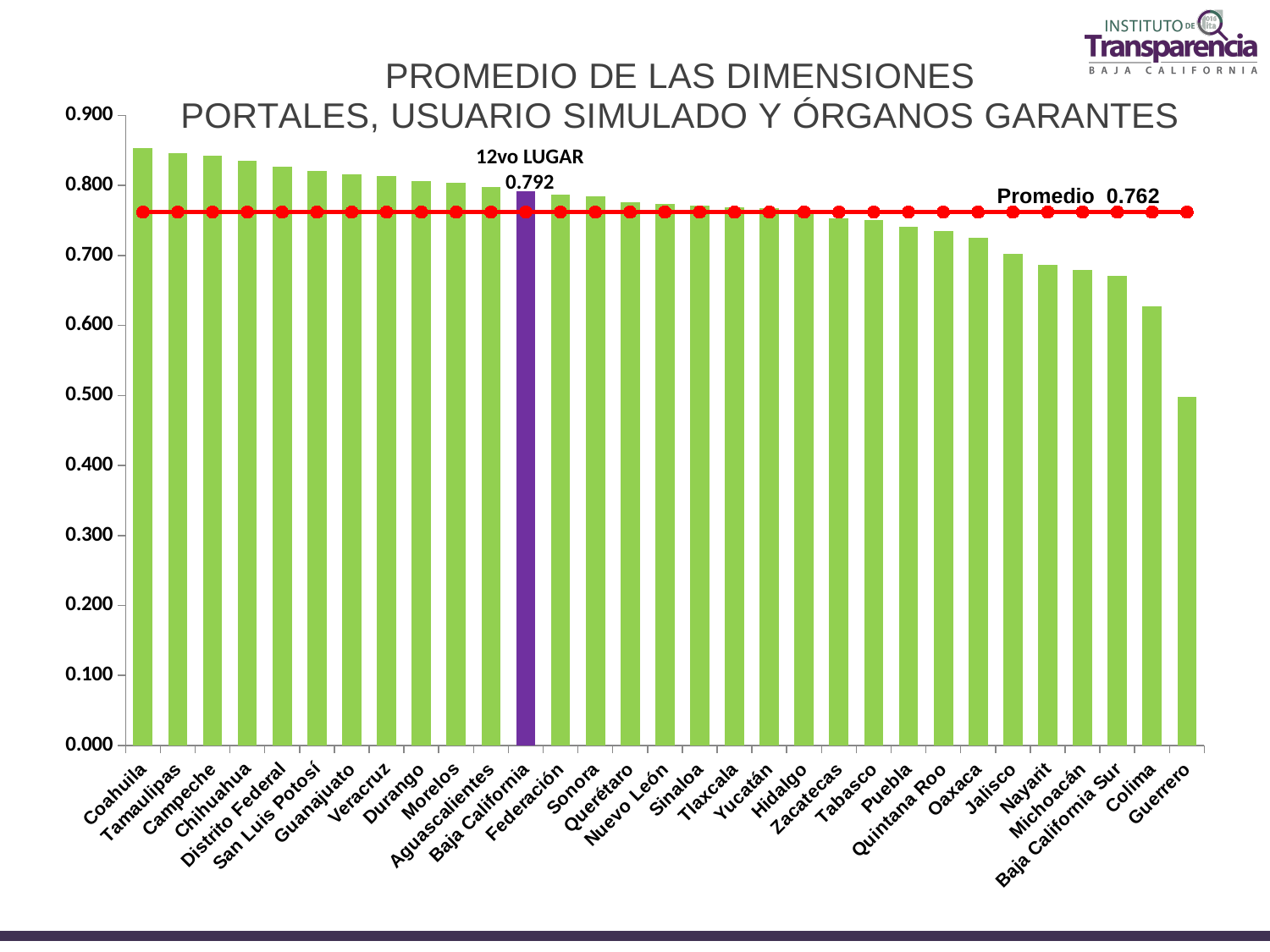
What is the value shown for Baja California? 0.792 Which state's bar is coloured purple instead of green? Baja California Which state has the highest bar? Coahuila Do the bar values rise or fall from left to right along the x axis? Fall Is the value for Coahuila greater or less than 0.800? greater How many categories are shown on the x axis? 31 What is the value of the Promedio line? 0.762 By how much does the value for Baja California exceed the Promedio of 0.762? 0.030 Is the value for Guerrero greater or less than 0.600? less Which is larger, the value for Colima or the value for Guerrero? Colima Which state has the lowest bar? Guerrero What kind of chart is this? Bar chart